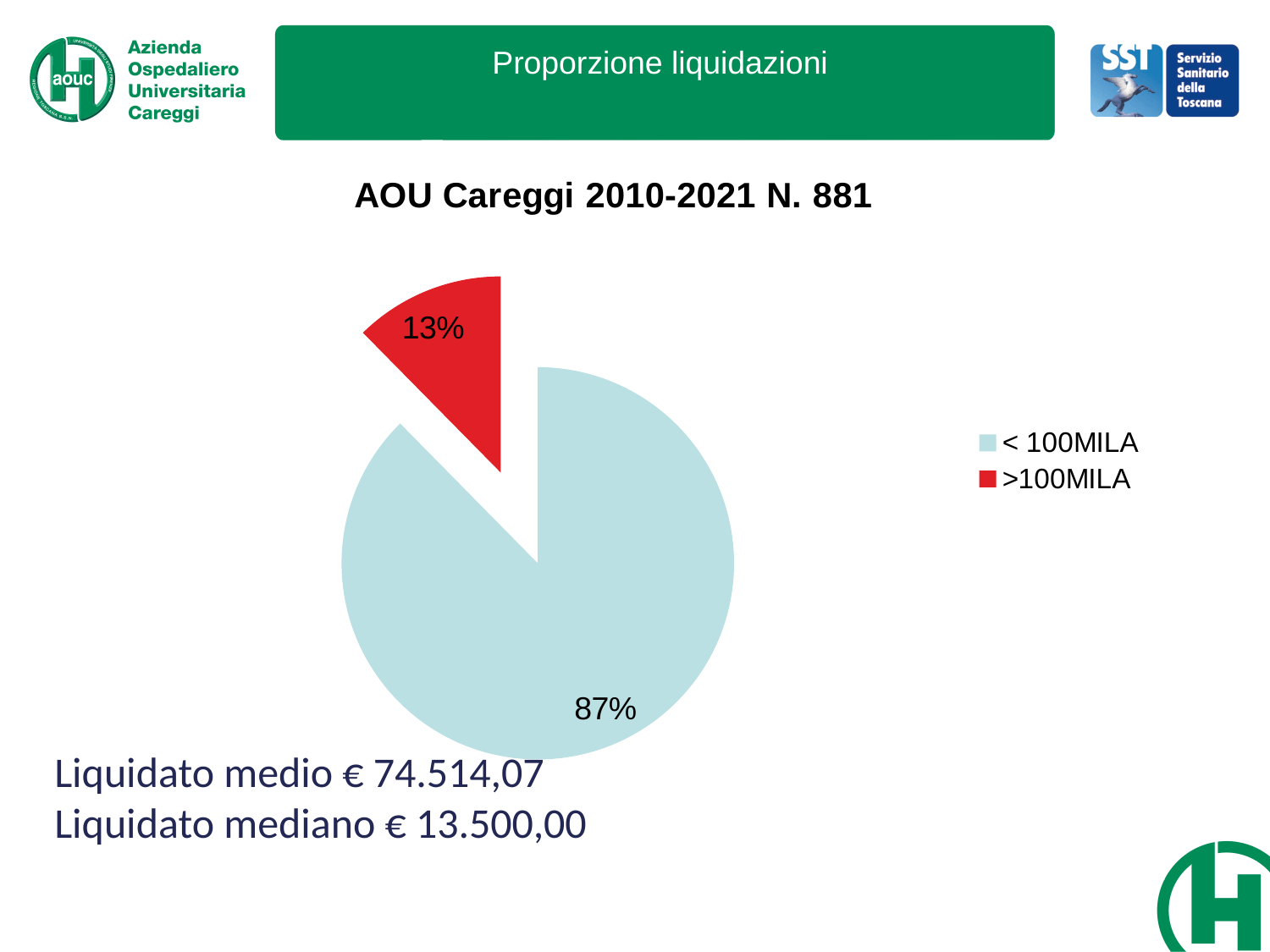
What share of the pie does the ">100MILA" slice represent? 13% What share of the pie does the "< 100MILA" slice represent? 87% What kind of chart is shown on the slide? pie chart What is the difference in percentage points between the "< 100MILA" and ">100MILA" slices? 74 How many slices does the pie chart have? 2 How many entries does the legend list? 2 What is the title of the chart? AOU Careggi 2010-2021 N. 881 Which slice is larger, "< 100MILA" or ">100MILA"? < 100MILA Which category has the largest slice of the pie? < 100MILA Which category has the smallest slice of the pie? >100MILA What colour is the ">100MILA" slice? red